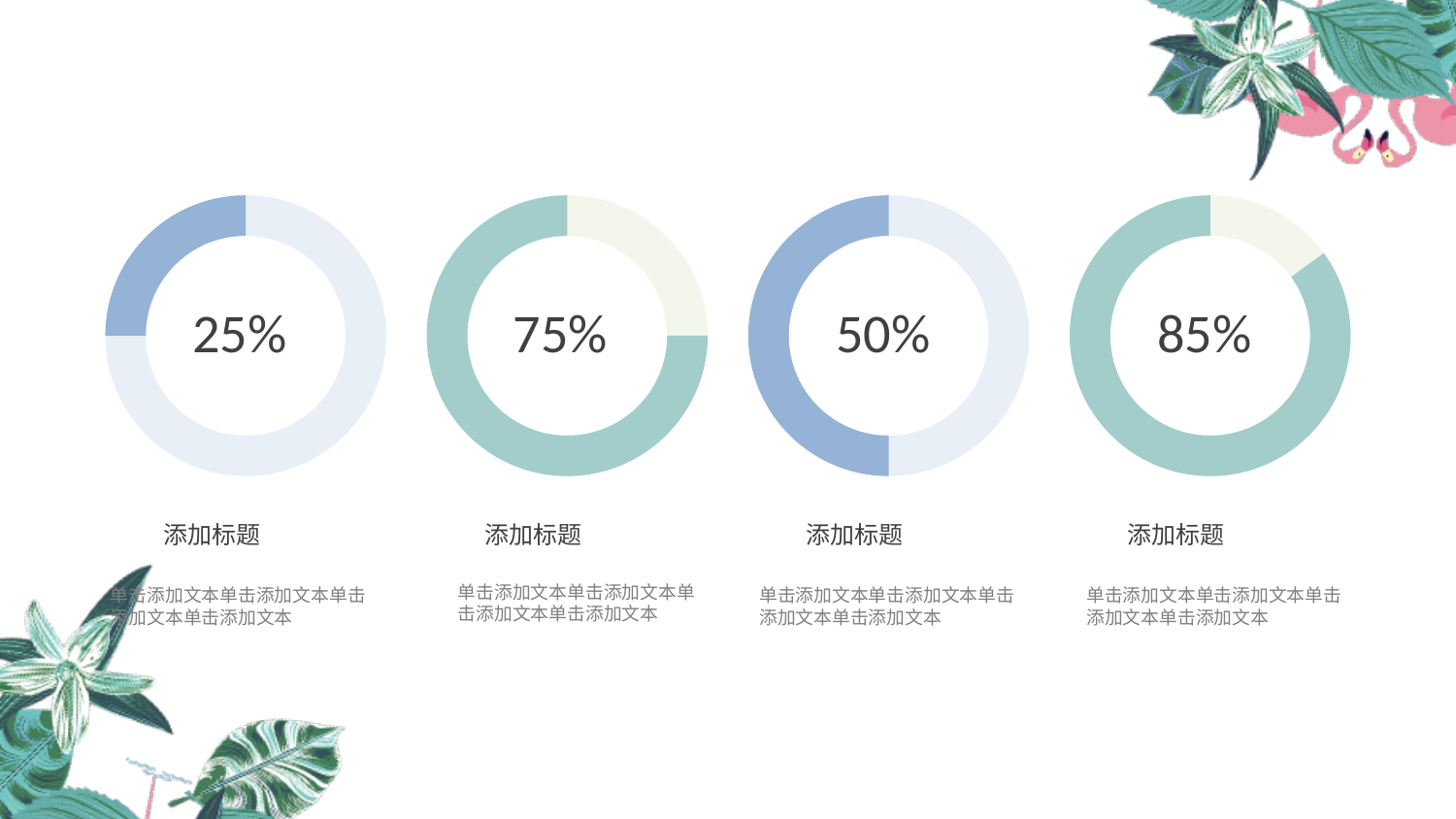
What is the difference between the percentages shown in the second and third donut charts from the left? 25% What value is shown in the centre of the second donut chart from the left? 75% Which is larger: the percentage in the second donut chart from the left or the percentage in the third donut chart from the left? The second chart (75%) How many donut charts are on the slide? 4 What kind of chart is used to display the percentages on this slide? Donut chart What colour is the filled portion of the third donut chart from the left? Blue What value is shown in the centre of the third donut chart from the left? 50% What value is shown in the centre of the leftmost donut chart? 25% What is the difference between the percentage in the rightmost donut chart and the percentage in the leftmost donut chart? 60% Which of the four donut charts shows the lowest percentage? The leftmost chart (25%) Which of the four donut charts shows the highest percentage? The rightmost chart (85%) What value is shown in the centre of the rightmost donut chart? 85%